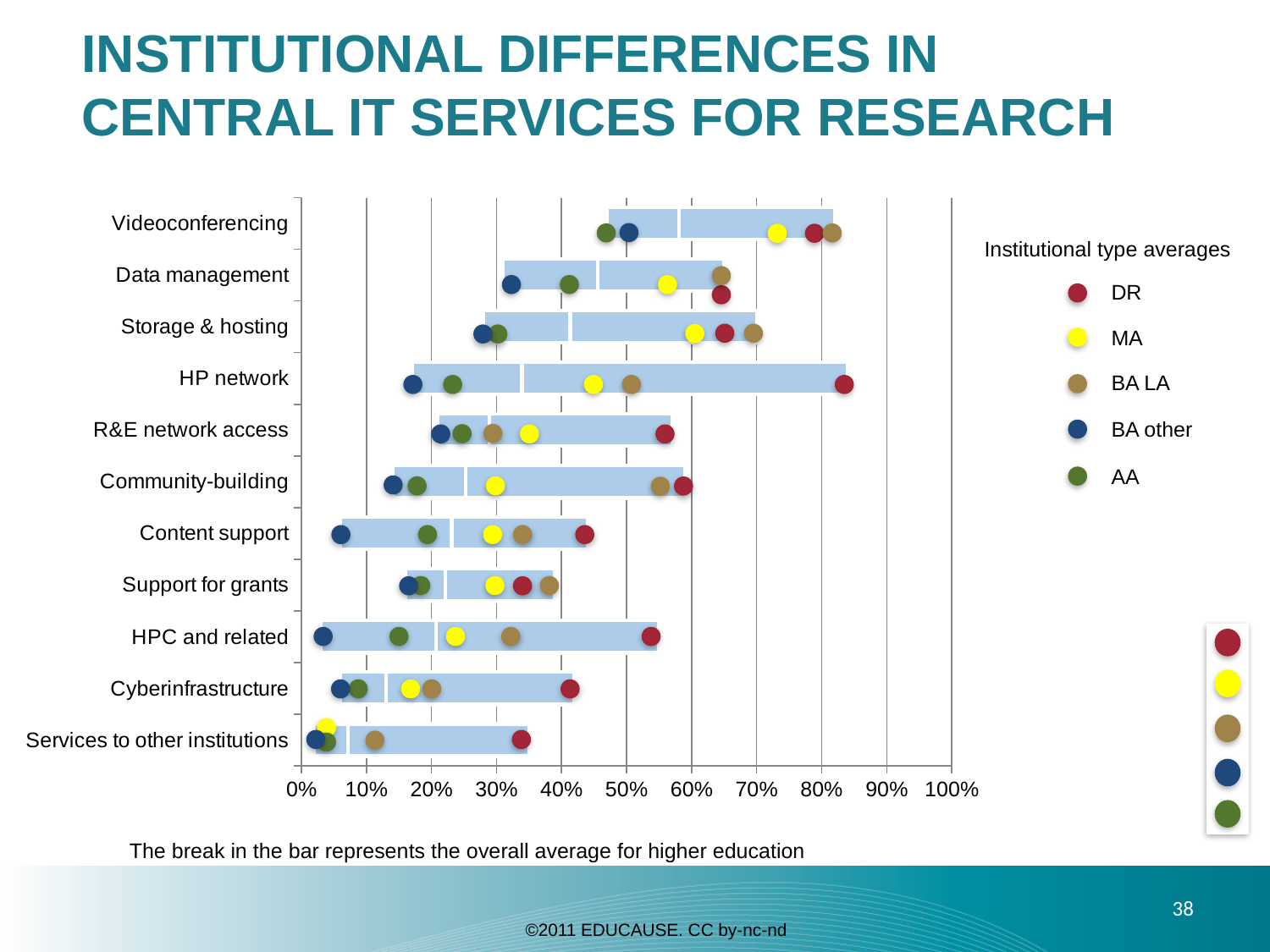
Is the BA other average for HPC and related greater or less than 10%? less What is the title of the chart legend? Institutional type averages For Videoconferencing, which institutional type has the higher average, DR or AA? DR How many institutional types does the chart legend list? 5 Is the DR average for Cyberinfrastructure greater or less than 30%? greater Is the BA other average for Content support greater or less than 10%? less For HPC and related, which institutional type has the higher average, DR or MA? DR According to the note below the chart, what does the break in each bar represent? The overall average for higher education How many service categories are listed on the y axis of the chart? 11 What kind of chart is shown on the slide? bar chart